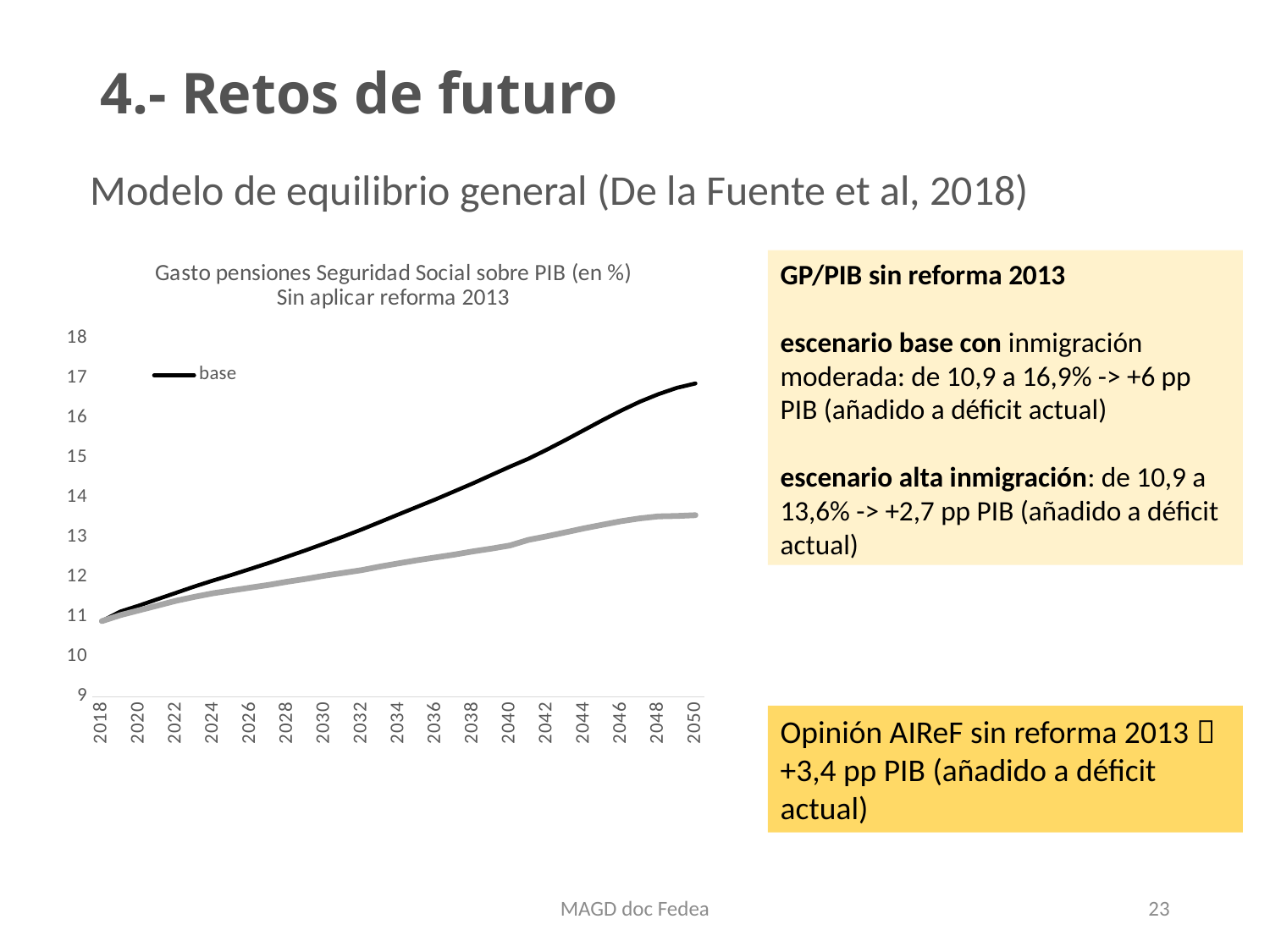
How many series does the chart's legend list? 1 Is the value of the grey line in 2050 greater or less than 14? less How many year labels are shown on the x axis? 17 What is the title of the chart? Gasto pensiones Seguridad Social sobre PIB (en %) Sin aplicar reforma 2013 In 2050, which line is higher, the black 'base' line or the grey line? the black 'base' line Is the value of the grey line in 2030 greater or less than 13? less Does the 'base' line rise or fall from 2018 to 2050? rise What kind of chart is shown on the slide? line chart What is the name of the series listed in the legend? base Is the value of the 'base' line in 2050 greater or less than 16? greater